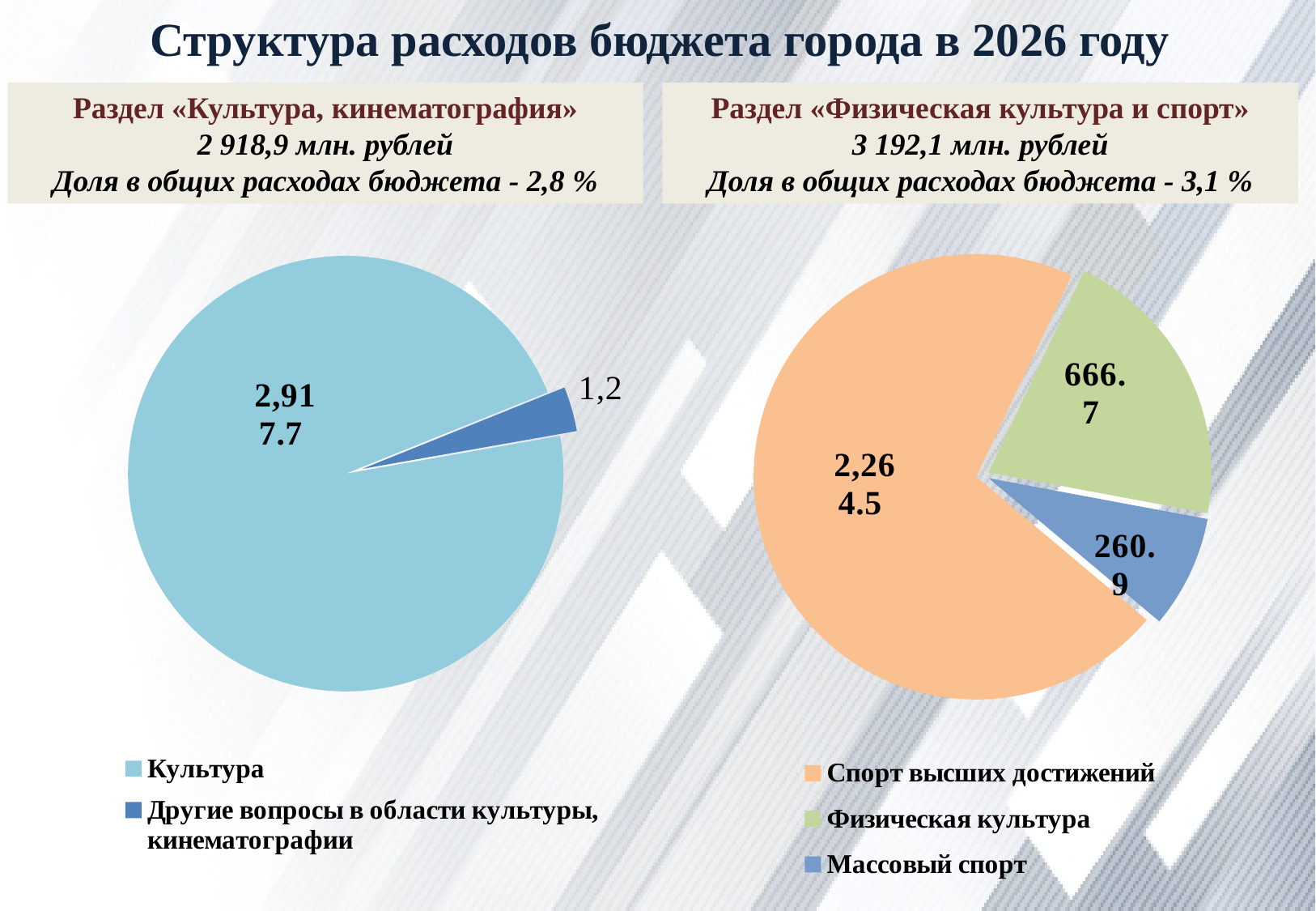
How many slices does the left pie chart («Культура, кинематография») have? 2 In the right pie chart («Физическая культура и спорт»), what is the difference between Физическая культура and Массовый спорт? 405.8 In the left pie chart («Культура, кинематография»), what is the value for Другие вопросы в области культуры, кинематографии? 1,2 What kind of chart is used for the «Культура, кинематография» section on the left? pie chart In the right pie chart («Физическая культура и спорт»), what is the value for Физическая культура? 666.7 In the right pie chart («Физическая культура и спорт»), what colour is the Спорт высших достижений slice? orange In the right pie chart («Физическая культура и спорт»), which category has the largest value? Спорт высших достижений In the right pie chart («Физическая культура и спорт»), which category has the smallest value? Массовый спорт In the right pie chart («Физическая культура и спорт»), which is larger: Физическая культура or Массовый спорт? Физическая культура How many categories does the legend of the right pie chart («Физическая культура и спорт») list? 3 In the left pie chart («Культура, кинематография»), what is the value for Культура? 2,917.7 In the right pie chart («Физическая культура и спорт»), what is the value for Массовый спорт? 260.9